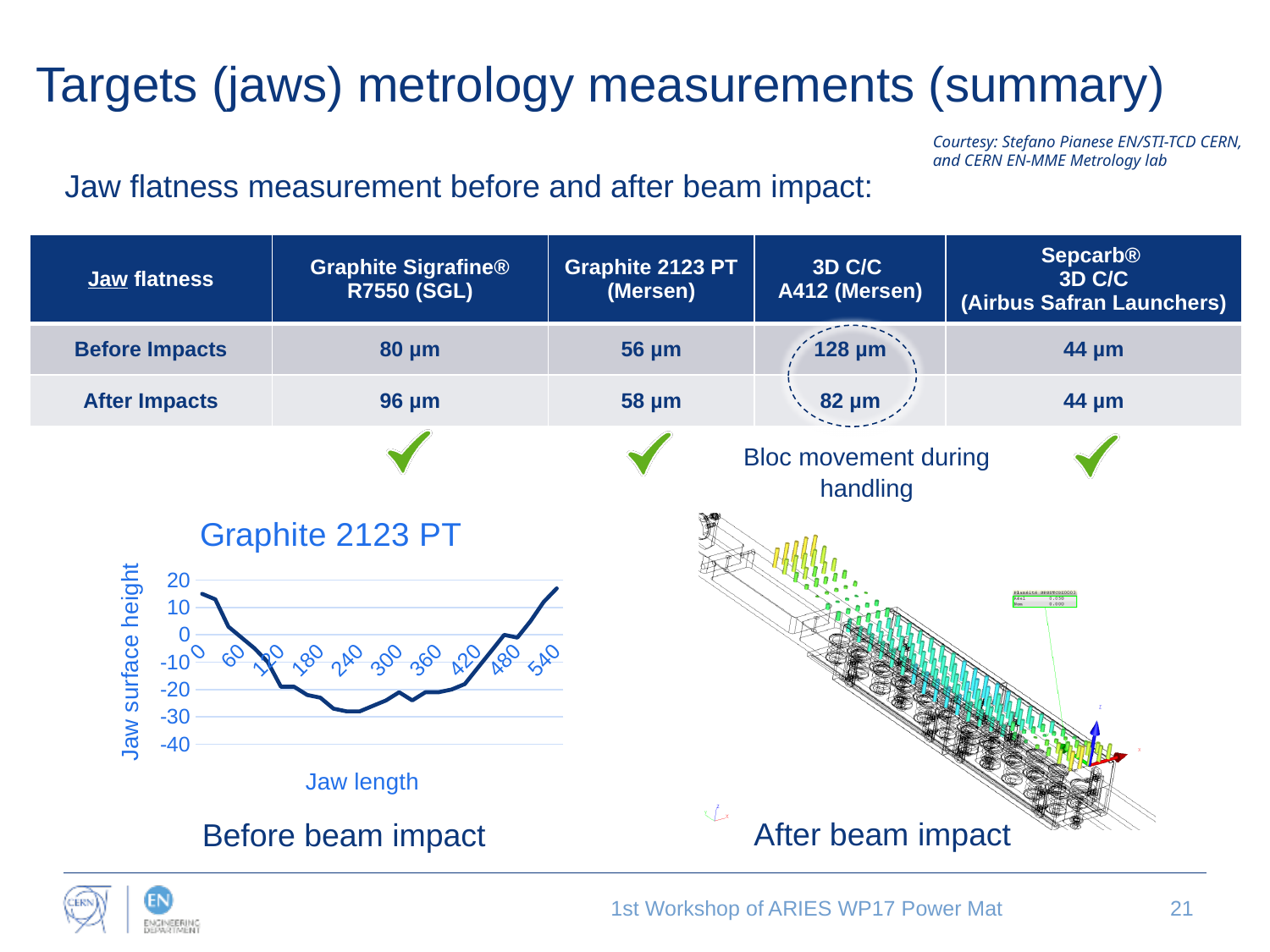
In the Graphite 2123 PT chart, does the jaw surface height rise or fall between jaw length 360 and jaw length 540? rise How many lines are plotted in the Graphite 2123 PT chart? 1 What is the label of the vertical axis of the Graphite 2123 PT chart? Jaw surface height In the Graphite 2123 PT chart, is the jaw surface height at jaw length 0 greater or less than 10? greater In the Graphite 2123 PT chart, is the lowest point of the line near the start, the middle, or the end of the jaw length axis? middle What is the title of the chart on the lower left of the slide? Graphite 2123 PT In the Graphite 2123 PT chart, does the jaw surface height rise or fall between jaw length 0 and jaw length 240? fall What kind of chart is shown under the heading 'Graphite 2123 PT'? line chart In the Graphite 2123 PT chart, is the jaw surface height at jaw length 120 greater or less than 0? less In the Graphite 2123 PT chart, is the jaw surface height at jaw length 240 greater or less than -20? less